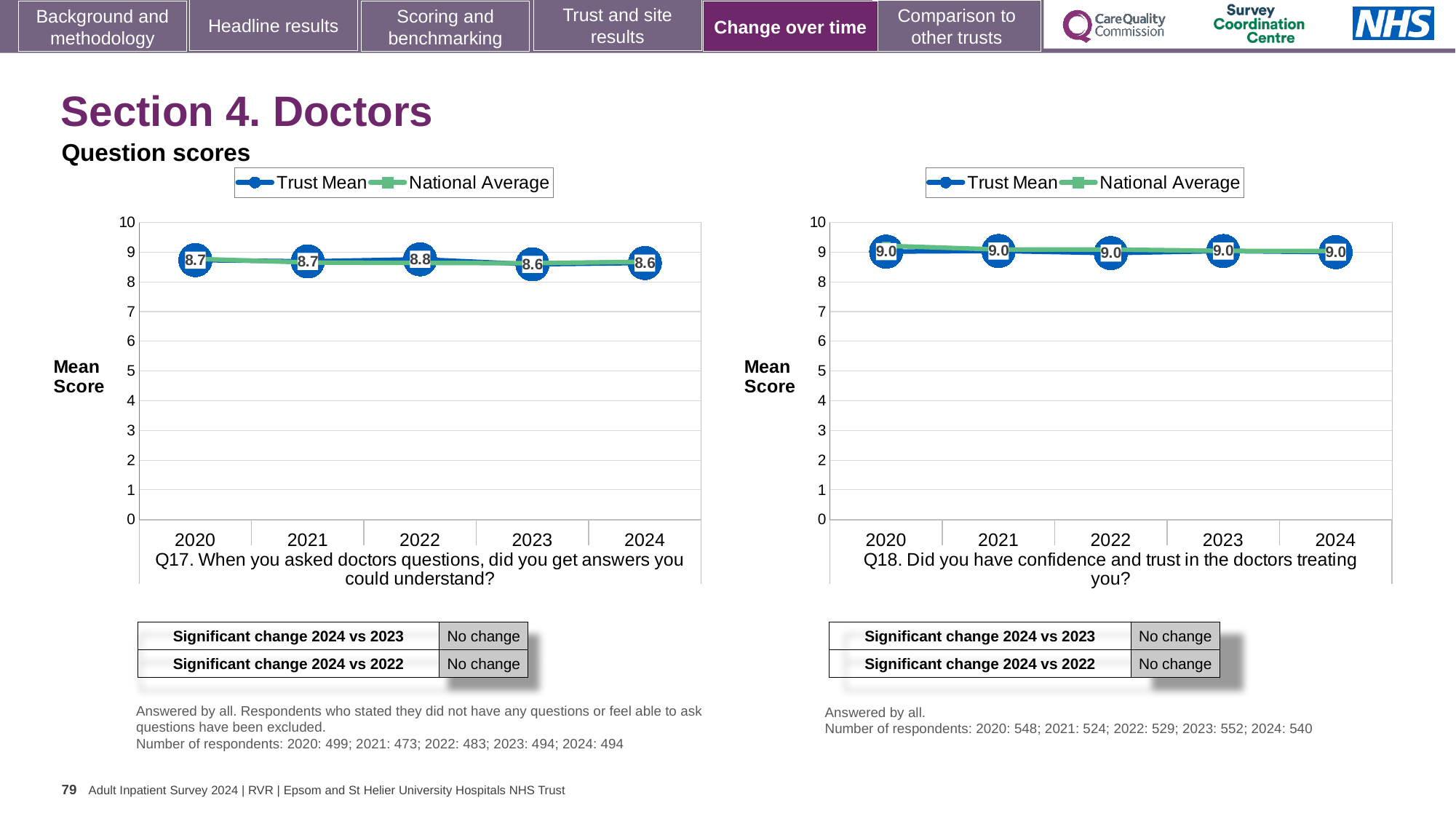
In the Q18 chart on the right, what is the Trust Mean score for 2020? 9.0 How many series does the legend of the Q17 chart on the left list? 2 In the Q18 chart on the right, does the Trust Mean score rise, fall or stay the same from 2020 to 2024? stays the same In the Q17 chart on the left, what is the difference between the Trust Mean scores for 2022 and 2024? 0.2 What are the two series named in the legend of the Q18 chart on the right? Trust Mean and National Average In the Q17 chart on the left, what is the Trust Mean score for 2022? 8.8 In the Q17 chart on the left, is the Trust Mean score for 2020 larger or smaller than the score for 2023? larger How many years are plotted on the x axis of the Q18 chart on the right? 5 What kind of chart is the Q18 chart on the right? line chart In the Q18 chart on the right, is the National Average value for 2024 greater or less than 5? greater In the Q17 chart on the left, what is the Trust Mean score for 2024? 8.6 In the Q17 chart on the left, which year has the highest Trust Mean score? 2022